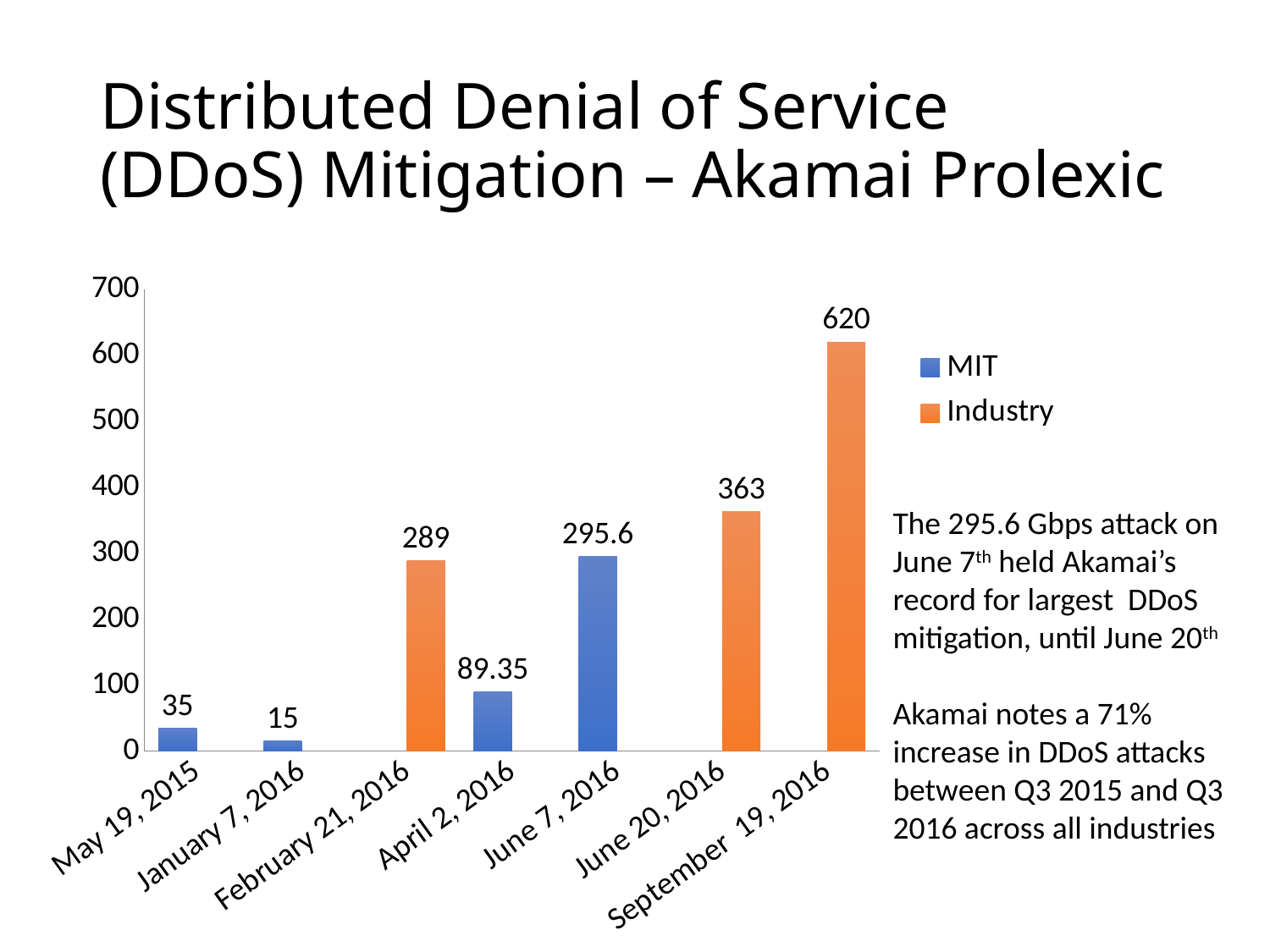
How many series does the legend list? 2 How many dates are shown on the x axis? 7 Is the value for June 20, 2016 greater or less than 300? greater What is the difference between the values for September 19, 2016 and June 20, 2016? 257 What is the value for April 2, 2016? 89.35 What is the value for September 19, 2016? 620 What is the value for June 7, 2016? 295.6 Which date has the lowest value? January 7, 2016 What kind of chart is shown? bar chart Which series does the bar for May 19, 2015 belong to? MIT Which date has the highest value? September 19, 2016 Which is larger, the value for February 21, 2016 or the value for June 7, 2016? June 7, 2016